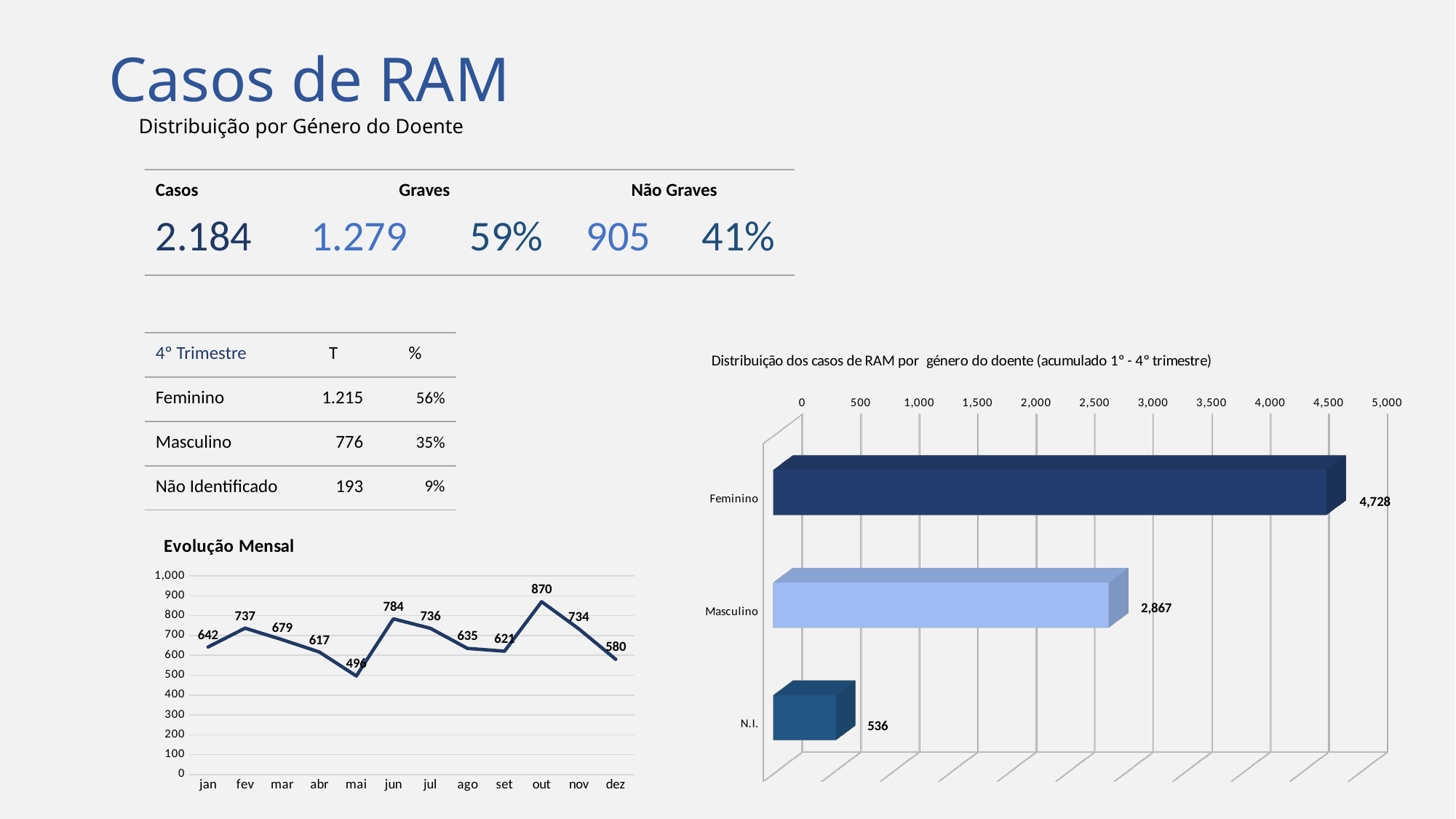
In the 'Distribuição dos casos de RAM por género do doente' chart, what is the difference between Feminino and Masculino? 1,861 What kind of chart is the 'Evolução Mensal' chart? line chart In the 'Distribuição dos casos de RAM por género do doente' chart, which category has the highest value? Feminino In the 'Evolução Mensal' chart, what is the value for out? 870 In the 'Evolução Mensal' chart, what is the difference between the values for out and dez? 290 In the 'Evolução Mensal' chart, how many months are plotted? 12 In the 'Evolução Mensal' chart, do the values rise or fall from out to dez? fall In the 'Evolução Mensal' chart, what is the value for mai? 496 In the 'Distribuição dos casos de RAM por género do doente' chart, what is the value for Masculino? 2,867 In the 'Evolução Mensal' chart, which month has the lowest value? mai In the 'Evolução Mensal' chart, which month has the highest value? out What kind of chart is the 'Distribuição dos casos de RAM por género do doente' chart? bar chart